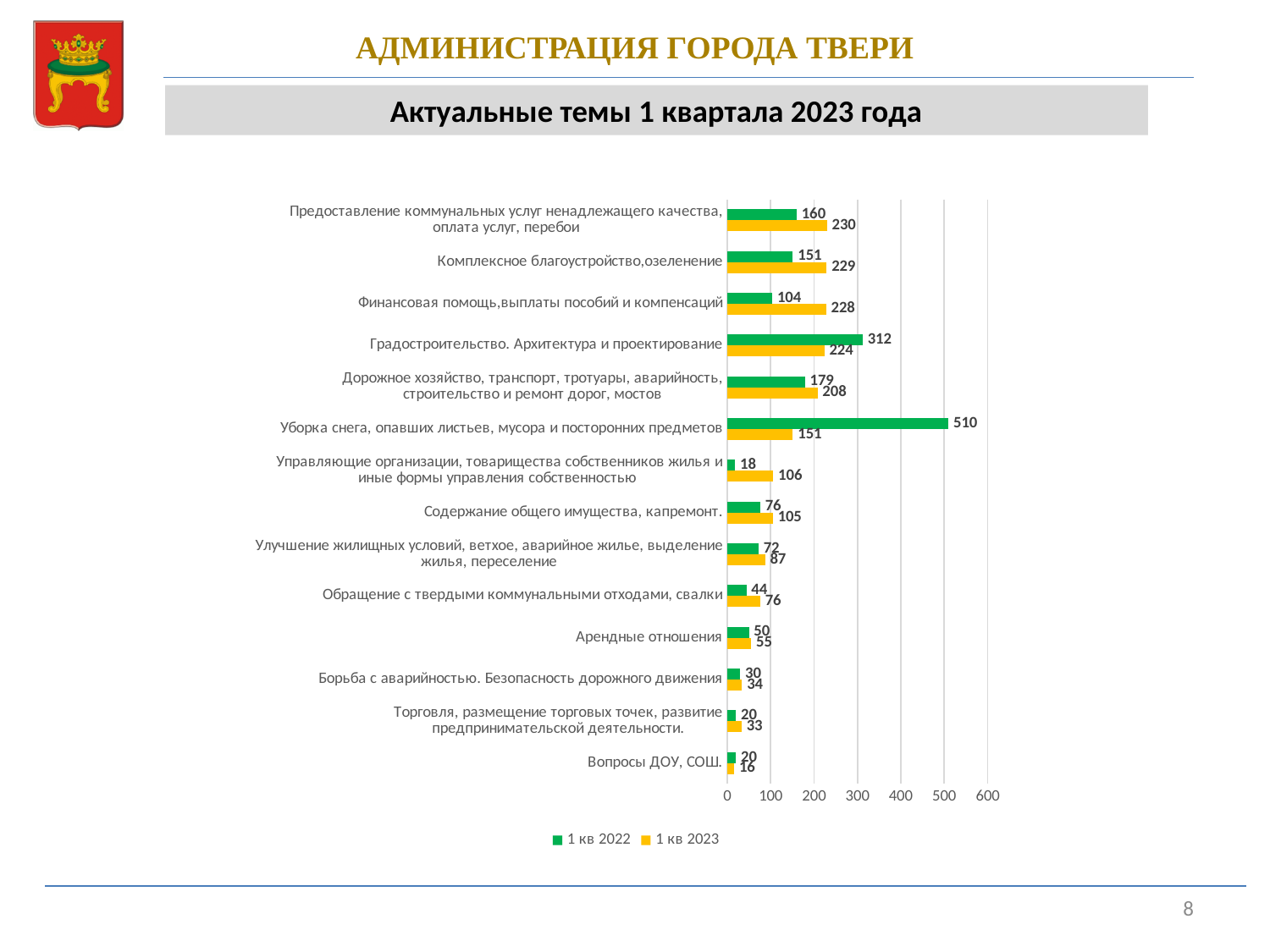
Which category has the highest value in the "1 кв 2022" series? Уборка снега, опавших листьев, мусора и посторонних предметов What is the value for "Уборка снега, опавших листьев, мусора и посторонних предметов" in the "1 кв 2022" series? 510 For "Градостроительство. Архитектура и проектирование", which series has the larger value, "1 кв 2022" or "1 кв 2023"? 1 кв 2022 Which category has the lowest value in the "1 кв 2023" series? Вопросы ДОУ, СОШ. What type of chart is shown on the slide? Bar chart What colour represents the "1 кв 2023" series in the chart? Yellow Is the "1 кв 2023" value for "Дорожное хозяйство, транспорт, тротуары, аварийность, строительство и ремонт дорог, мостов" greater or less than 200? greater What is the value for "Комплексное благоустройство,озеленение" in the "1 кв 2023" series? 229 How many categories are shown in the chart? 14 What is the value for "Управляющие организации, товарищества собственников жилья и иные формы управления собственностью" in the "1 кв 2022" series? 18 What is the difference between the "1 кв 2023" and "1 кв 2022" values for "Финансовая помощь,выплаты пособий и компенсаций"? 124 How many series does the legend list? 2